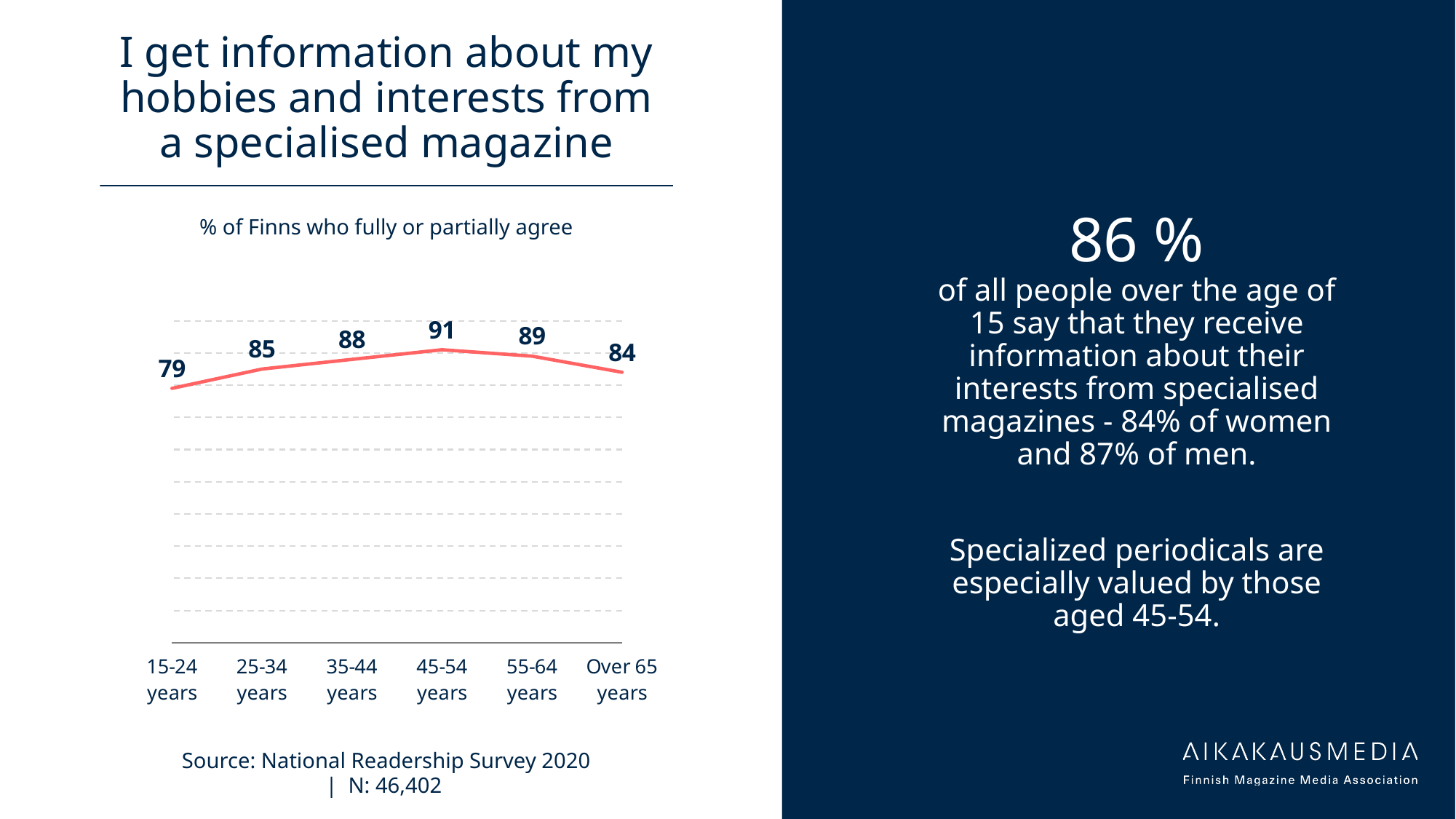
Which age group has the highest value? 45-54 years How many age groups are plotted on the chart? 6 What is the value for the 45-54 years age group? 91 What is the value for the 15-24 years age group? 79 Which age group has the lowest value? 15-24 years What is the difference between the values for 25-34 years and 35-44 years? 3 What kind of chart is shown on the slide? Line chart What is the value for the Over 65 years age group? 84 What is the difference between the values for 45-54 years and 15-24 years? 12 Which is larger, the value for 35-44 years or the value for 55-64 years? 55-64 years Do the values rise or fall from 15-24 years to 45-54 years? Rise What is the subtitle shown above the chart? % of Finns who fully or partially agree